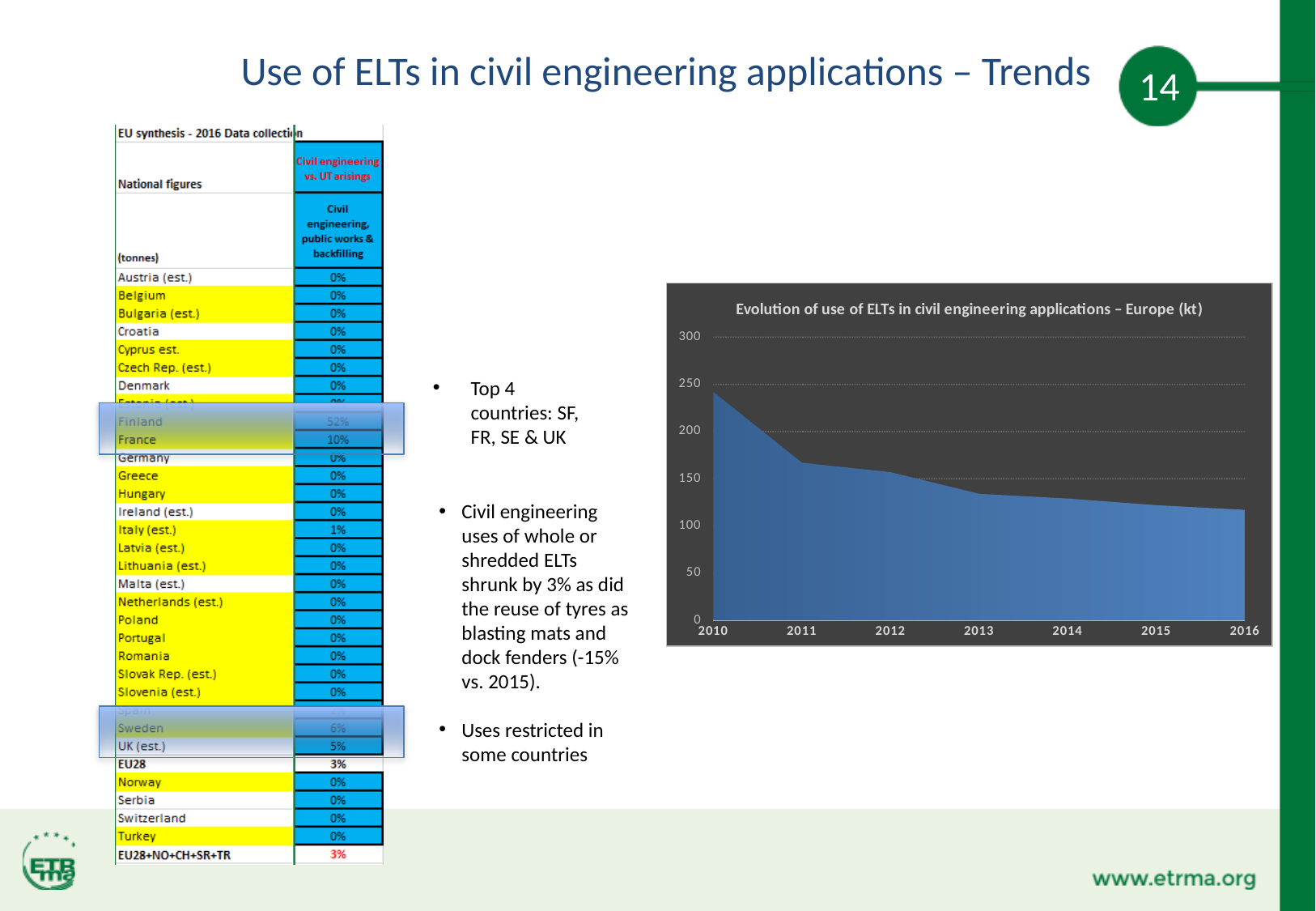
What is the highest value shown on the y axis of the chart? 300 Is the value for 2013 greater or less than 150? less Is the value for 2010 greater or less than 200? greater Is the value for 2011 greater or less than 200? less Do the values in the chart rise or fall from 2010 to 2016? fall How many years are plotted along the x axis of the chart? 7 What is the title of the chart on the slide? Evolution of use of ELTs in civil engineering applications – Europe (kt) What kind of chart is shown on the slide? area chart Which year has the larger value, 2011 or 2016? 2011 Which year has the larger value, 2010 or 2011? 2010 Which year has the highest value in the chart? 2010